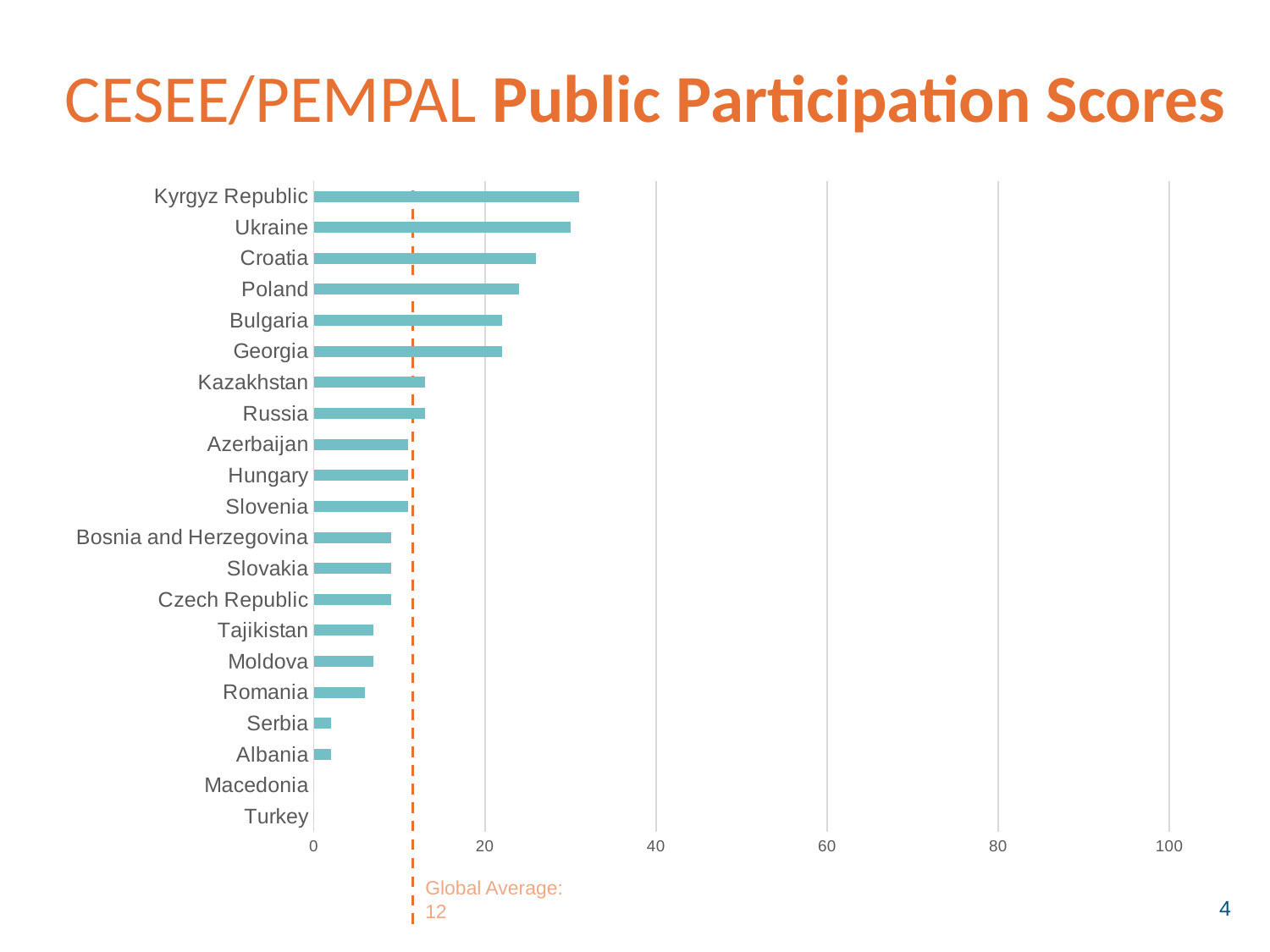
What kind of chart is shown on the slide? bar chart Is the value for Croatia greater or less than 20? greater Which has the larger value, Croatia or Romania? Croatia Is the value for Poland greater or less than 40? less Is the value for Kyrgyz Republic greater or less than 20? greater Which country is listed at the top of the chart? Kyrgyz Republic What is the Global Average value marked by the dashed line? 12 How many countries are listed on the chart? 21 Which has the larger value, Poland or Serbia? Poland Which countries show no visible bar on the chart? Macedonia and Turkey